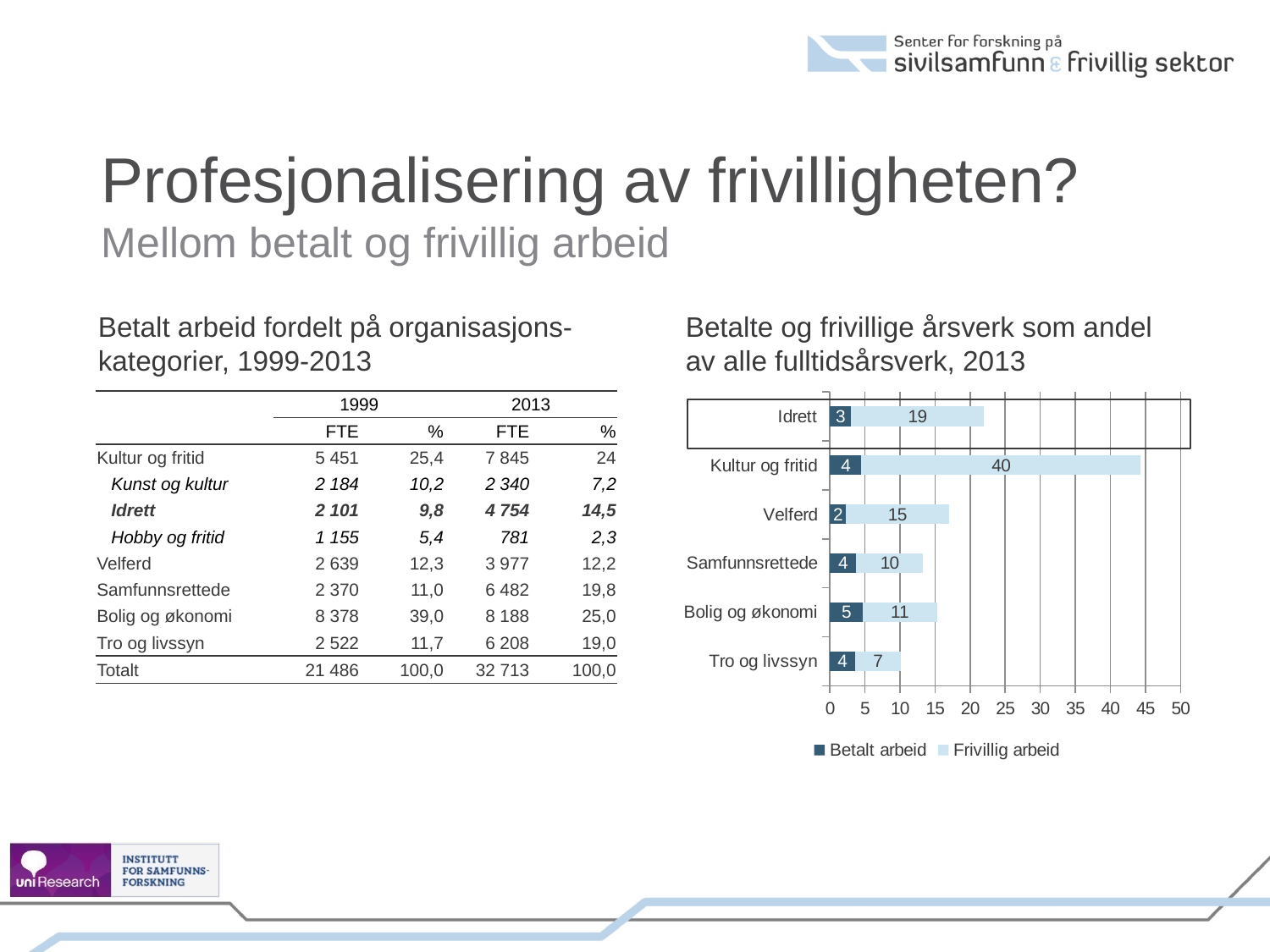
Which category has the lowest value for Betalt arbeid? Velferd What is the total of the stacked bar for Tro og livssyn? 11 What is the value of Betalt arbeid for Bolig og økonomi? 5 How many categories are shown in the chart? 6 What is the difference between the Frivillig arbeid values for Kultur og fritid and Idrett? 21 What is the value of Frivillig arbeid for Kultur og fritid? 40 What is the total of the stacked bar for Kultur og fritid? 44 Which category has the highest value for Frivillig arbeid? Kultur og fritid What is the value of Frivillig arbeid for Idrett? 19 Which is larger: the Frivillig arbeid value for Velferd or for Bolig og økonomi? Velferd How many series does the chart legend list? 2 What type of chart is shown on the slide? Bar chart